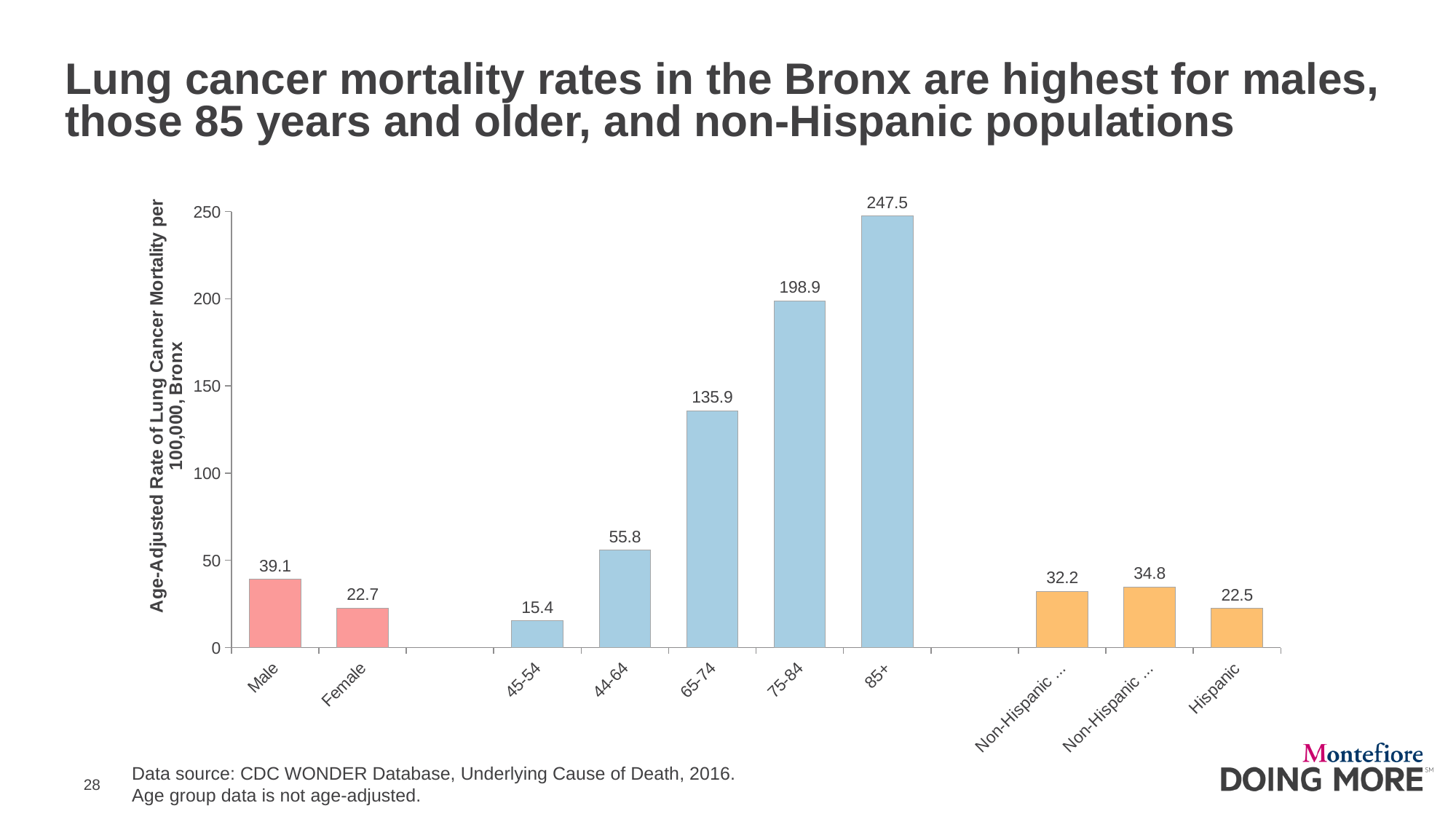
What is the lung cancer mortality rate for males? 39.1 What is the difference between the values for the 85+ and 75-84 age groups? 48.6 What kind of chart is shown on the slide? Bar chart What is the value shown for the Hispanic category? 22.5 Which category has the lowest bar in the chart? 45-54 Which is larger, the value for the 75-84 age group or the 65-74 age group? 75-84 What is the value shown for the 65-74 age group? 135.9 What is the value shown for the 85+ age group? 247.5 How many bars are plotted in the chart? 10 What is the difference between the male and female mortality rates? 16.4 Which category has the highest bar in the chart? 85+ What is the lung cancer mortality rate for females? 22.7